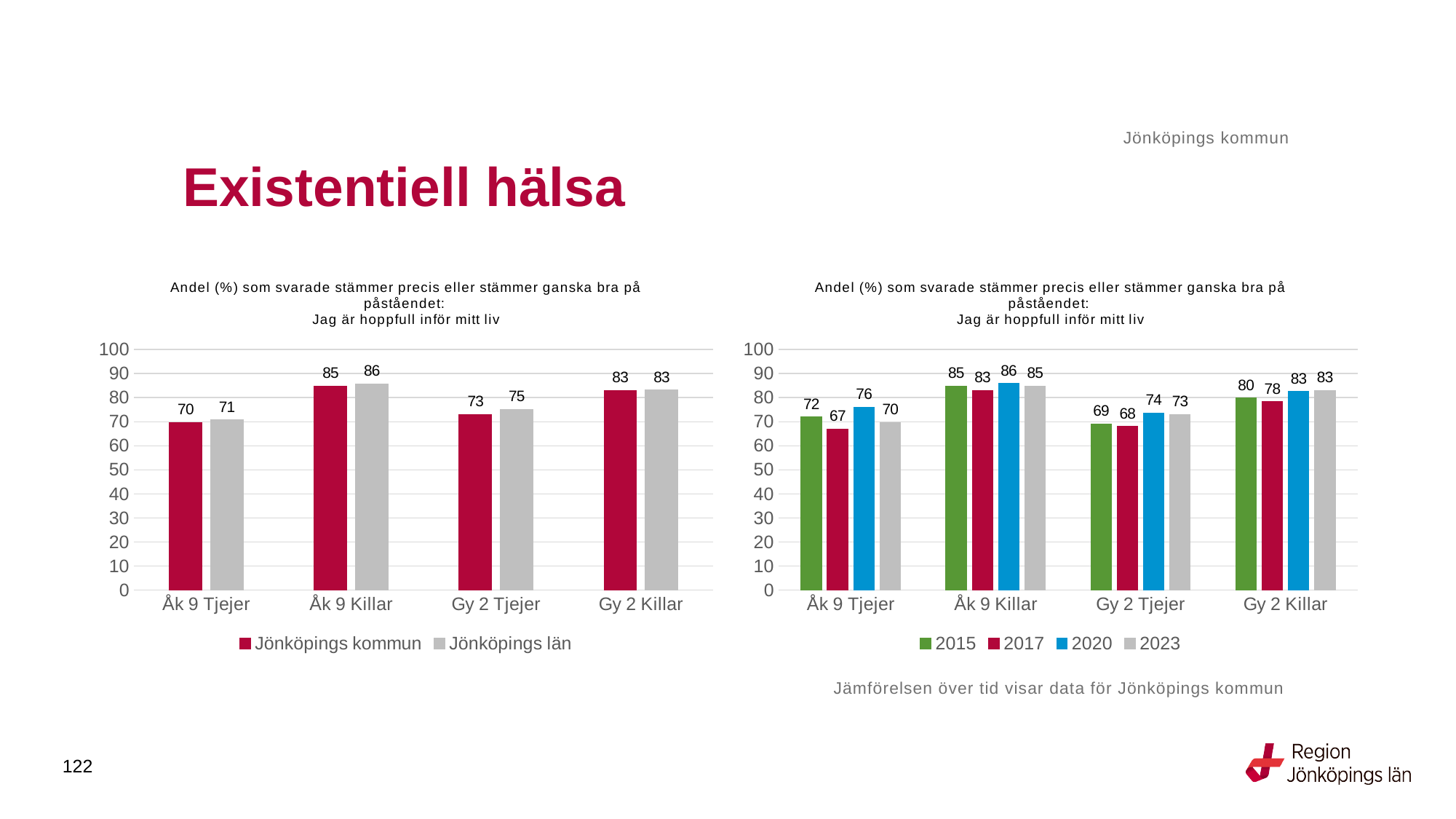
In the right chart, which is larger for Gy 2 Tjejer: the value for 2015 or the value for 2020? 2020 In the left chart, how many series does the legend list? 2 In the left chart, what is the difference between Jönköpings län and Jönköpings kommun for Åk 9 Tjejer? 1 In the left chart, which category has the highest value for Jönköpings kommun? Åk 9 Killar In the right chart, what is the difference between the 2020 and 2017 values for Åk 9 Tjejer? 9 In the left chart, what is the value for Jönköpings kommun for Åk 9 Tjejer? 70 In the right chart, which category has the lowest value for 2023? Åk 9 Tjejer What kind of chart is the left chart? Bar chart In the right chart, what is the value for 2020 for Gy 2 Killar? 83 In the left chart, what is the value for Jönköpings län for Gy 2 Tjejer? 75 In the right chart, how many series does the legend list? 4 In the right chart, what is the value for 2017 for Åk 9 Tjejer? 67